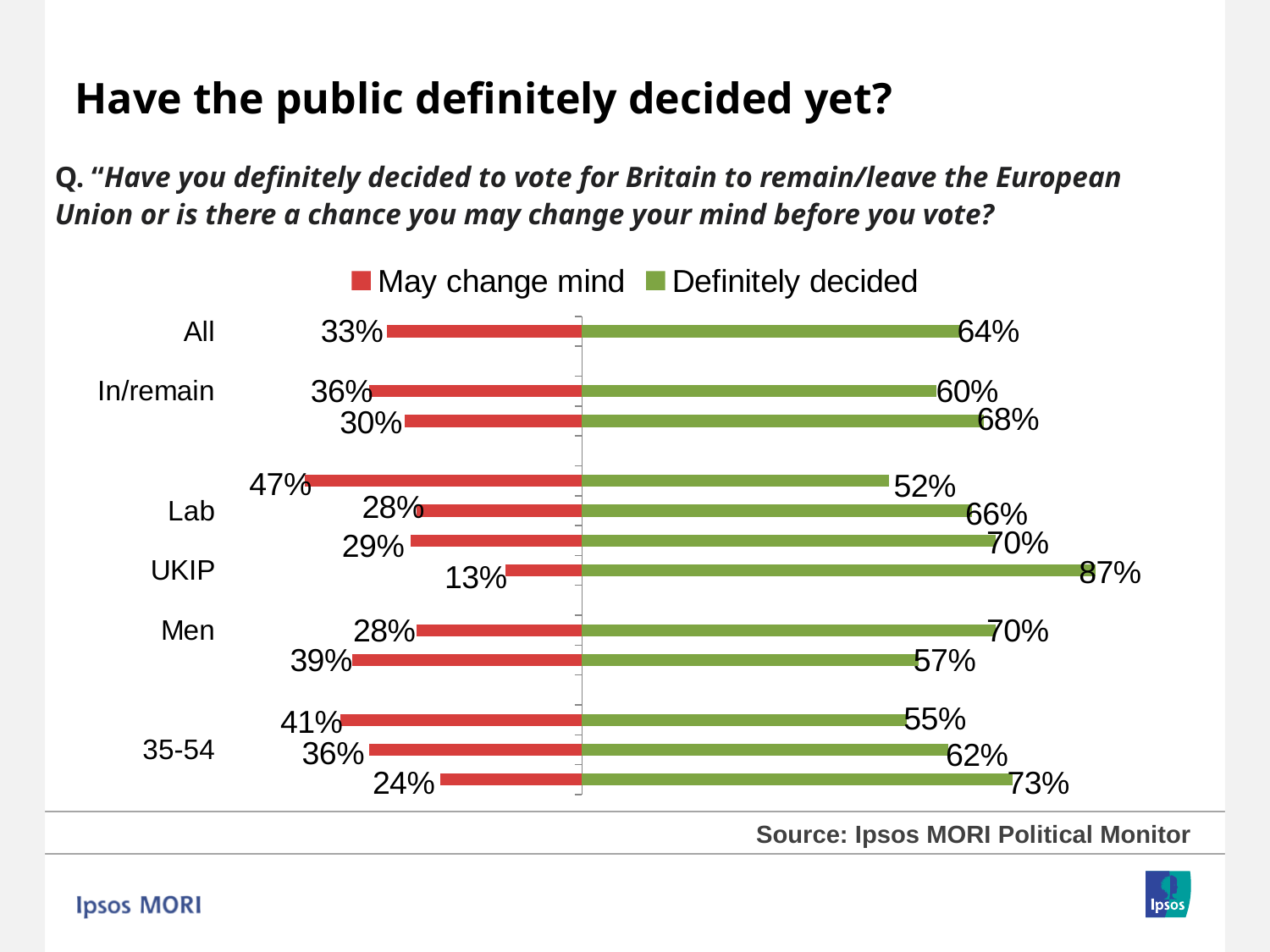
What is the 'May change mind' value for the 35-54 group? 36% Which labelled group has the lowest 'May change mind' value? UKIP What percentage of All respondents say they may change their mind? 33% What percentage of All respondents say they have definitely decided? 64% Which labelled group has the highest 'Definitely decided' value? UKIP How many series does the legend list? 2 What is the 'Definitely decided' value for UKIP? 87% For All respondents, how many percentage points higher is 'Definitely decided' than 'May change mind'? 31 percentage points Which colour represents 'May change mind' in the chart? Red What is the 'Definitely decided' value for Men? 70% What is the 'Definitely decided' value for In/remain? 60% What is the 'May change mind' value for UKIP? 13%